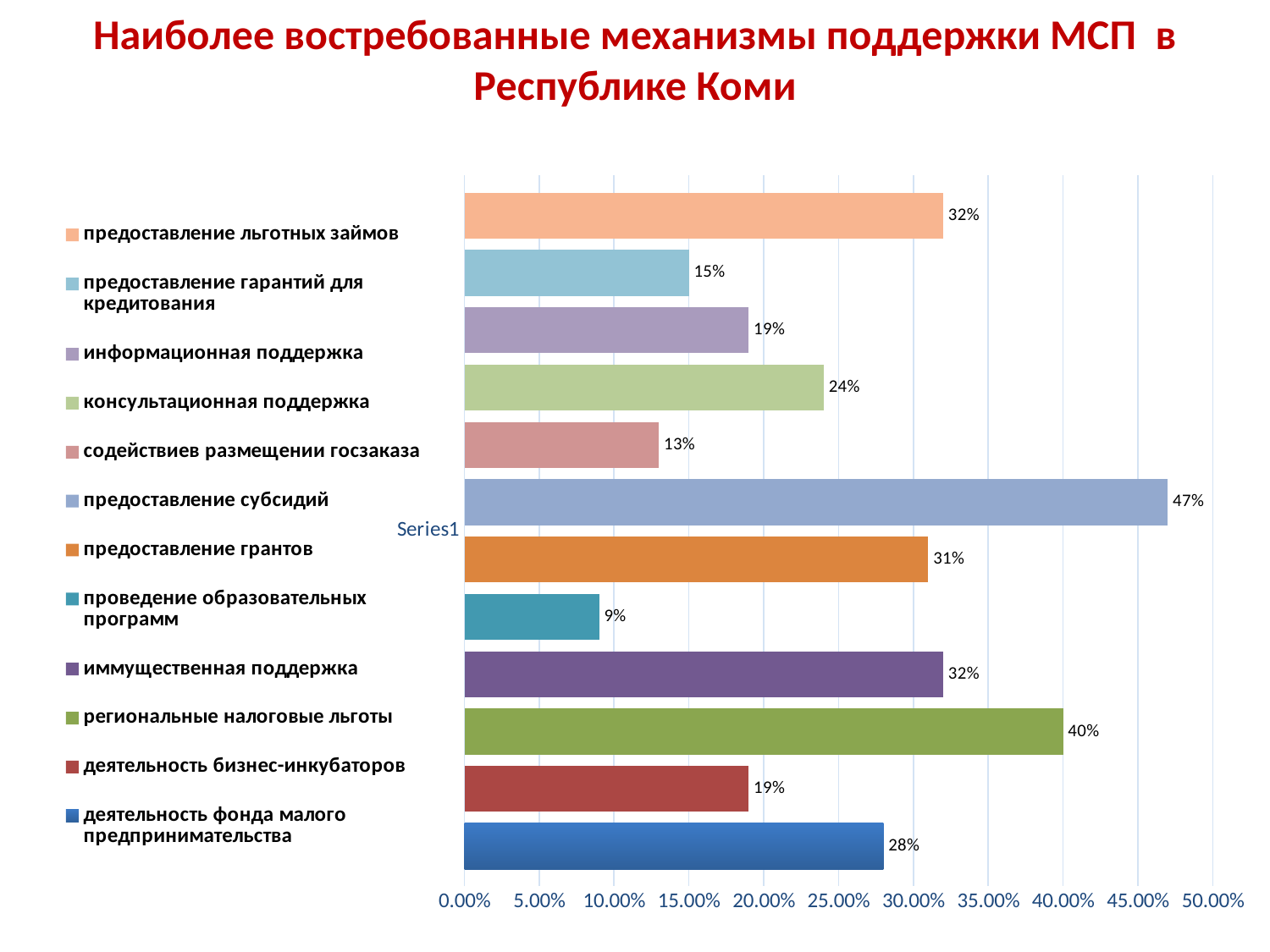
Which support mechanism has the lowest value? проведение образовательных программ What is the difference between the values for предоставление субсидий and предоставление грантов? 16% What value is shown for региональные налоговые льготы? 40% How many series does the legend list? 12 Which support mechanism has the highest value? предоставление субсидий What value is shown for проведение образовательных программ? 9% What kind of chart is shown on the slide? bar chart Is the value for содействие в размещении госзаказа greater or less than 15.00%? less Which is larger, the value for консультационная поддержка or the value for информационная поддержка? консультационная поддержка What value is shown for предоставление субсидий? 47% What value is shown for деятельность фонда малого предпринимательства? 28% What is the title of the slide? Наиболее востребованные механизмы поддержки МСП в Республике Коми